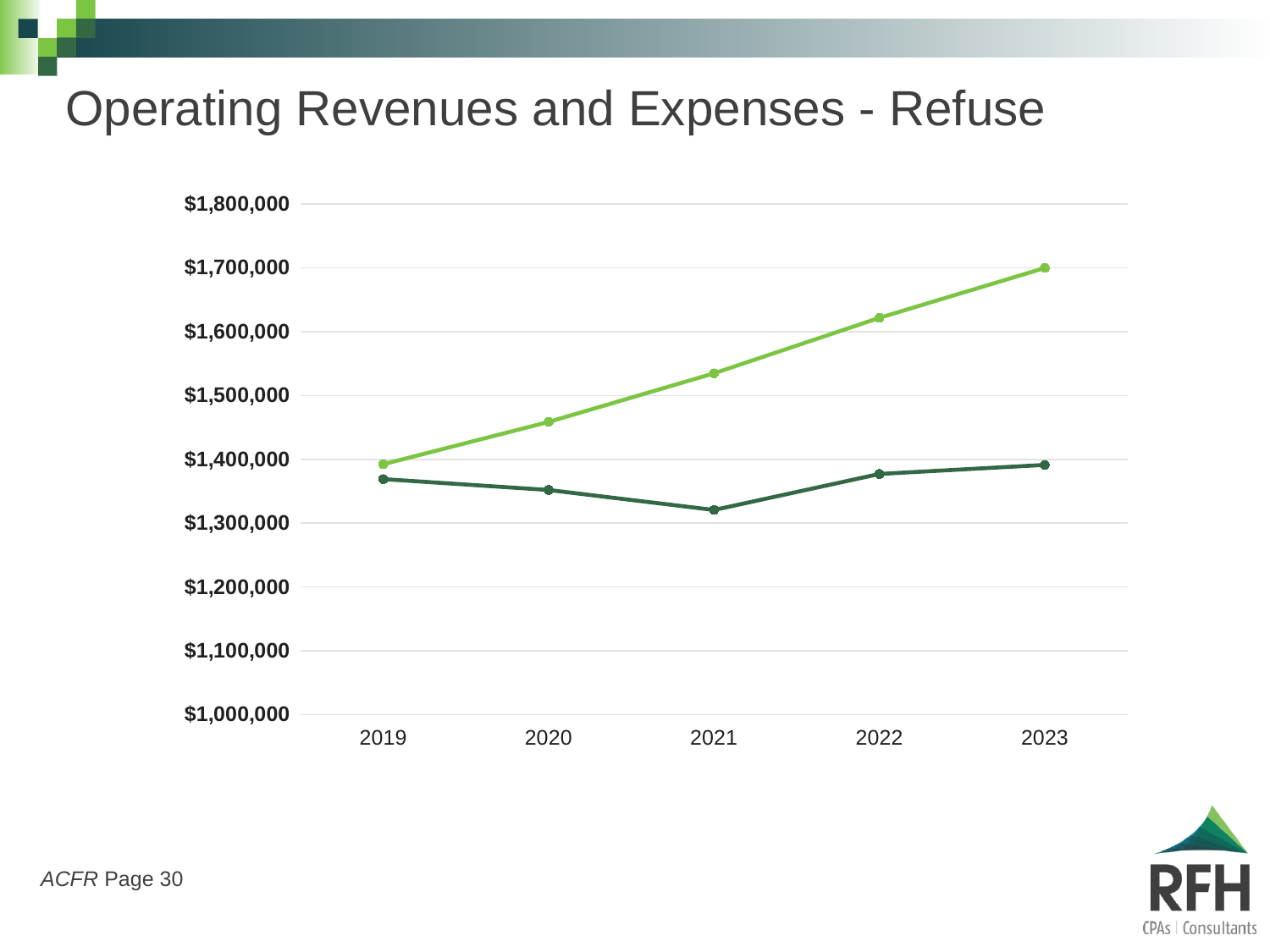
What is the title of the chart on the slide? Operating Revenues and Expenses - Refuse In which year is the light green line at its highest? 2023 Does the light green line rise or fall from 2019 to 2023? rise In which year is the light green line at its lowest? 2019 What kind of chart is shown on the slide? line chart Is the value of the light green line in 2020 greater or less than $1,500,000? less In which year is the dark green line at its lowest? 2021 Is the value of the dark green line in 2021 greater or less than $1,400,000? less How many lines are plotted on the chart? 2 How many years are shown on the x axis of the chart? 5 In 2023, which line has the higher value, the light green line or the dark green line? the light green line Is the value of the light green line in 2022 greater or less than $1,600,000? greater